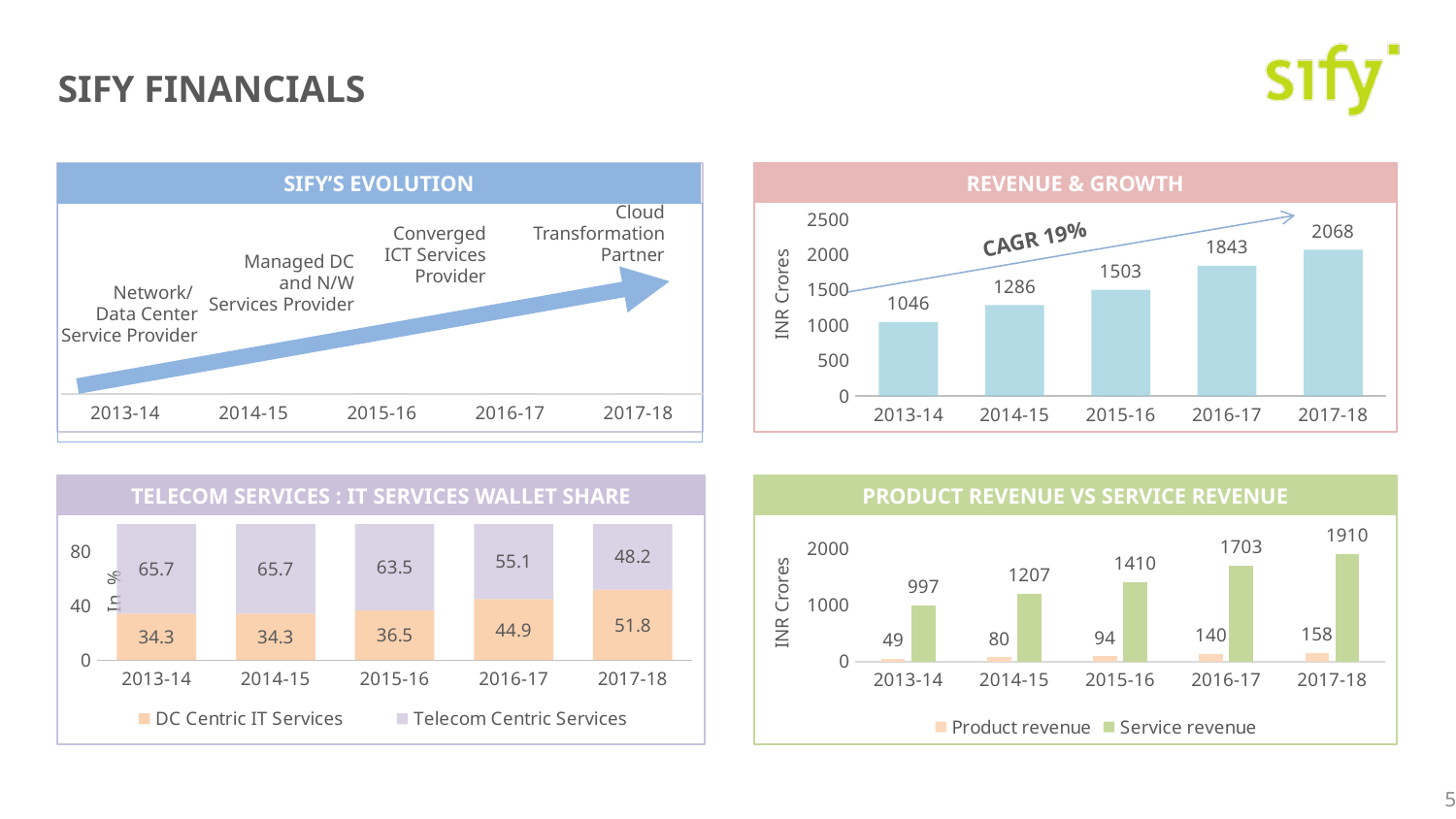
In the Product Revenue vs Service Revenue chart, what is the difference between service revenue and product revenue in 2017-18? 1752 In the Product Revenue vs Service Revenue chart, which is larger in 2014-15, product revenue or service revenue? Service revenue In the Telecom Services : IT Services Wallet Share chart, what is the value for Telecom Centric Services in 2016-17? 55.1 In the Telecom Services : IT Services Wallet Share chart, what is the total of the stacked bar for 2015-16? 100 In the Product Revenue vs Service Revenue chart, what is the product revenue for 2016-17? 140 In the Telecom Services : IT Services Wallet Share chart, which year has the highest value for DC Centric IT Services? 2017-18 In the Revenue & Growth chart, what is the difference between the 2017-18 and 2013-14 values? 1022 In the Revenue & Growth chart, which year has the highest revenue? 2017-18 In the Revenue & Growth chart, what is the revenue for 2015-16? 1503 In the Revenue & Growth chart, do the values rise or fall from 2013-14 to 2017-18? rise In the Revenue & Growth chart, what CAGR is shown on the chart? CAGR 19% In the Telecom Services : IT Services Wallet Share chart, how many series does the legend list? 2